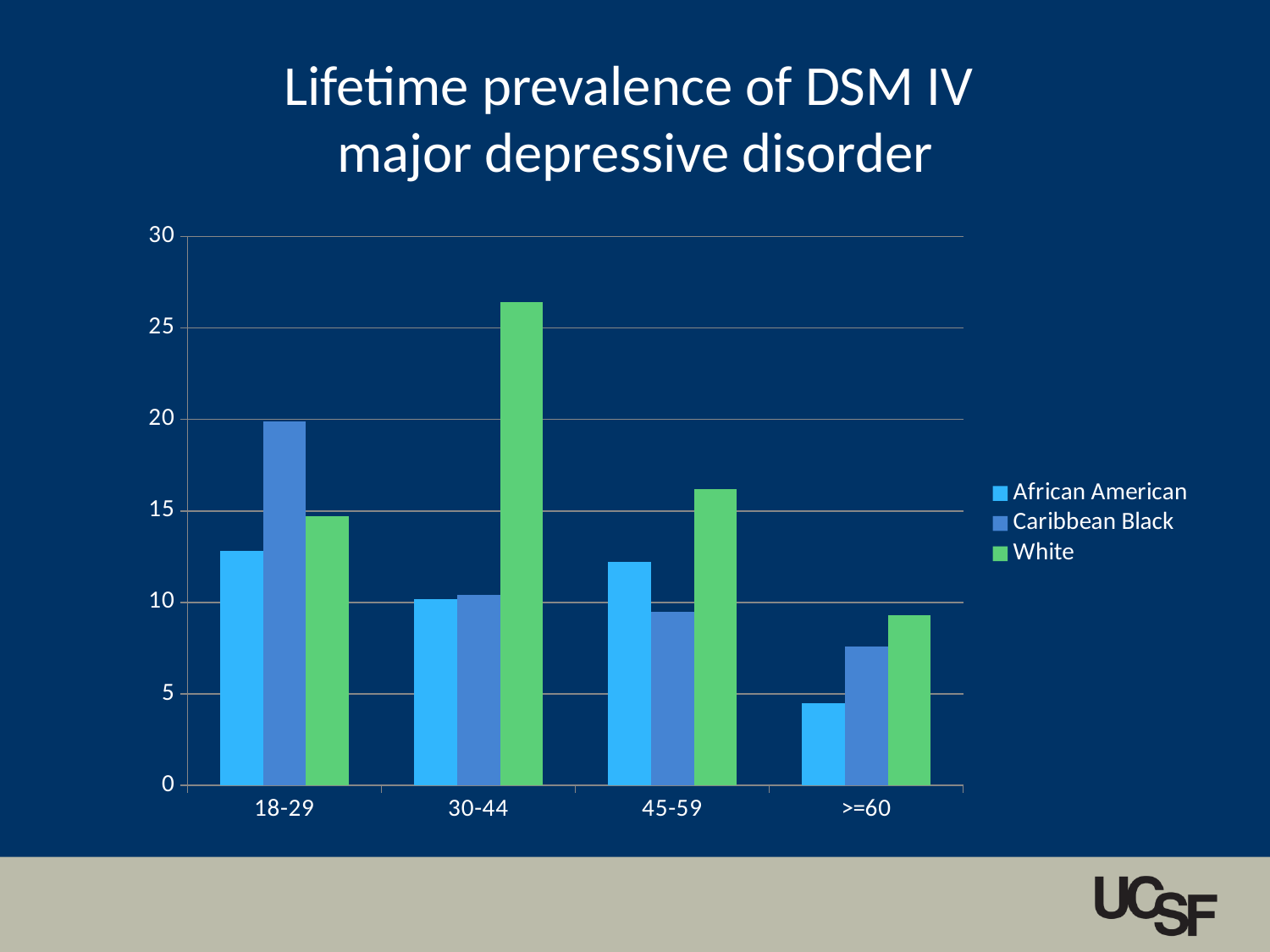
Is the value for African American in the >=60 age group greater or less than 5? less How many age groups are shown on the x axis? 4 In the 18-29 age group, which is larger: Caribbean Black or White? Caribbean Black Which series has the lowest value in the >=60 age group? African American Is the value for White in the 45-59 age group greater or less than 15? greater What kind of chart is shown on the slide? bar chart In the 45-59 age group, which is larger: African American or Caribbean Black? African American Is the value for Caribbean Black in the 18-29 age group greater or less than 15? greater Which age group has the highest value for the White series? 30-44 How many series does the legend list? 3 What is the title of the chart? Lifetime prevalence of DSM IV major depressive disorder